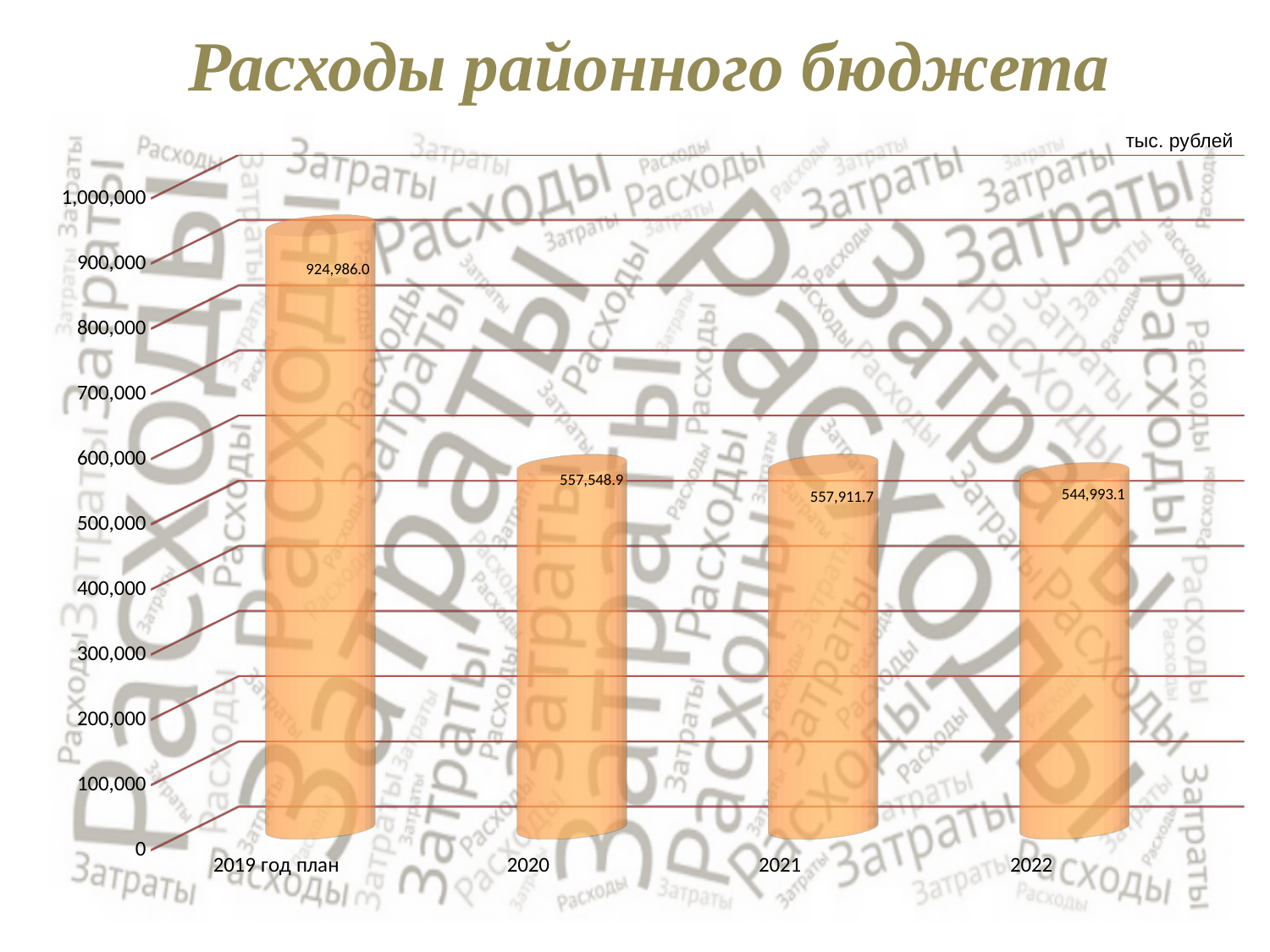
What is the value for 2021? 557,911.7 Is the value for 2020 greater or less than 600,000? less What is the value for 2019 год план? 924,986.0 Which is larger, the value for 2019 год план or the value for 2022? 2019 год план What is the difference between the values for 2021 and 2022? 12,918.6 What is the title of the chart? Расходы районного бюджета What is the value for 2022? 544,993.1 How many categories are shown on the x axis? 4 What is the value for 2020? 557,548.9 Which category has the highest value? 2019 год план What is the difference between the values for 2019 год план and 2020? 367,437.1 Which category has the lowest value? 2022